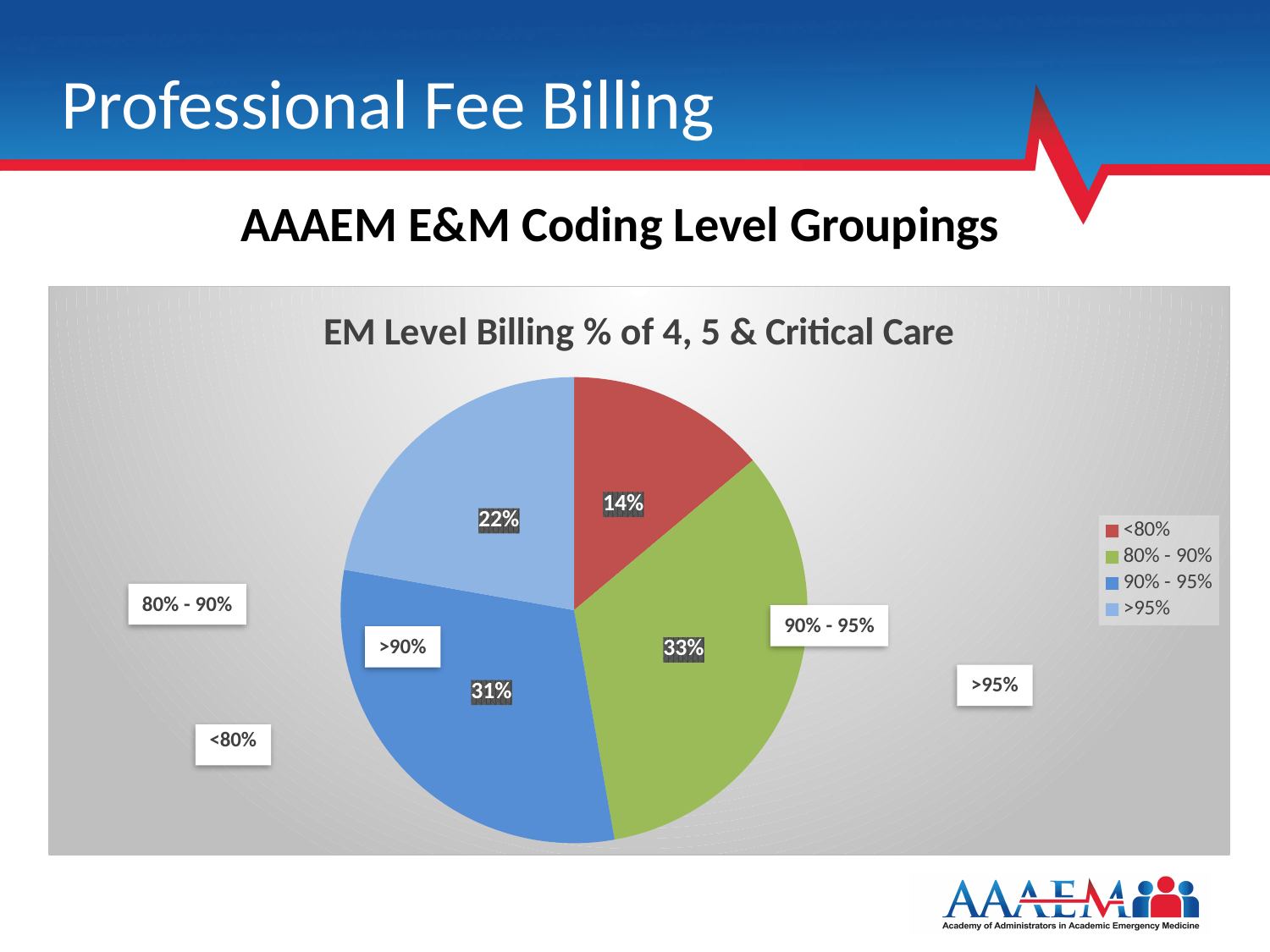
What is the difference in percentage points between the 80% - 90% slice and the <80% slice? 19 How many slices does the pie chart have? 4 What kind of chart is shown on the slide? pie chart Which category has the largest share of the pie? 80% - 90% How many entries does the chart legend list? 4 What percentage is shown for the 90% - 95% slice? 31% What percentage is shown for the <80% slice? 14% What is the title of the chart? EM Level Billing % of 4, 5 & Critical Care What percentage is shown for the >95% slice? 22% Which colour represents the >95% category in the legend? light blue Which category has the smallest share of the pie? <80% What percentage is shown for the 80% - 90% slice? 33%